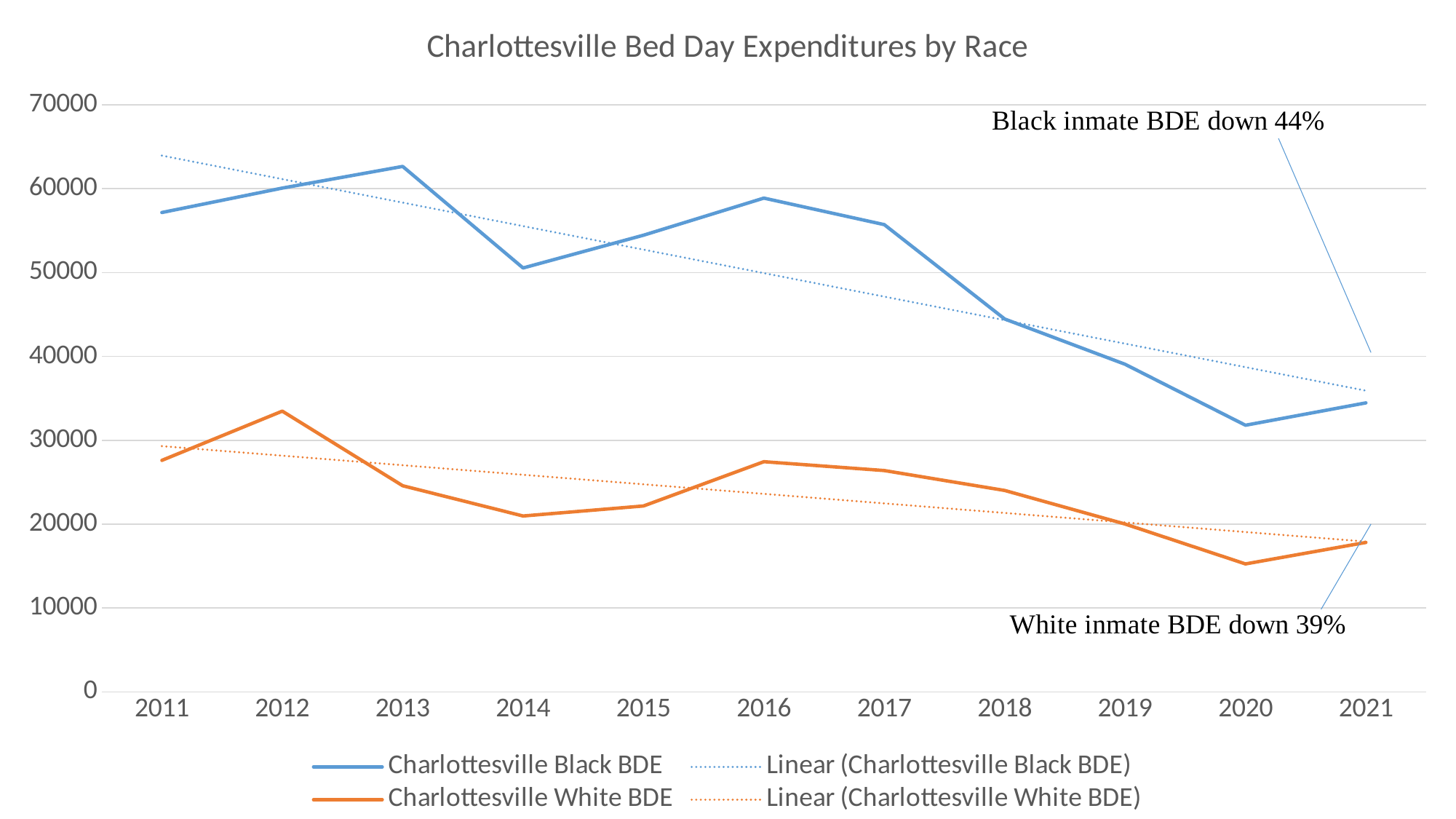
In which year is Charlottesville White BDE highest? 2012 How many entries does the legend list? 4 Overall, does Charlottesville Black BDE rise or fall from 2011 to 2021? fall How many years are plotted along the x axis? 11 Is the value for Charlottesville White BDE in 2020 greater or less than 20000? less What is the title of the chart? Charlottesville Bed Day Expenditures by Race Is the value for Charlottesville Black BDE in 2013 greater or less than 60000? greater Which is larger in 2016, Charlottesville Black BDE or Charlottesville White BDE? Charlottesville Black BDE In which year is Charlottesville Black BDE highest? 2013 Is the value for Charlottesville Black BDE in 2020 greater or less than 40000? less What type of chart is shown on the slide? line chart In which year is Charlottesville Black BDE lowest? 2020